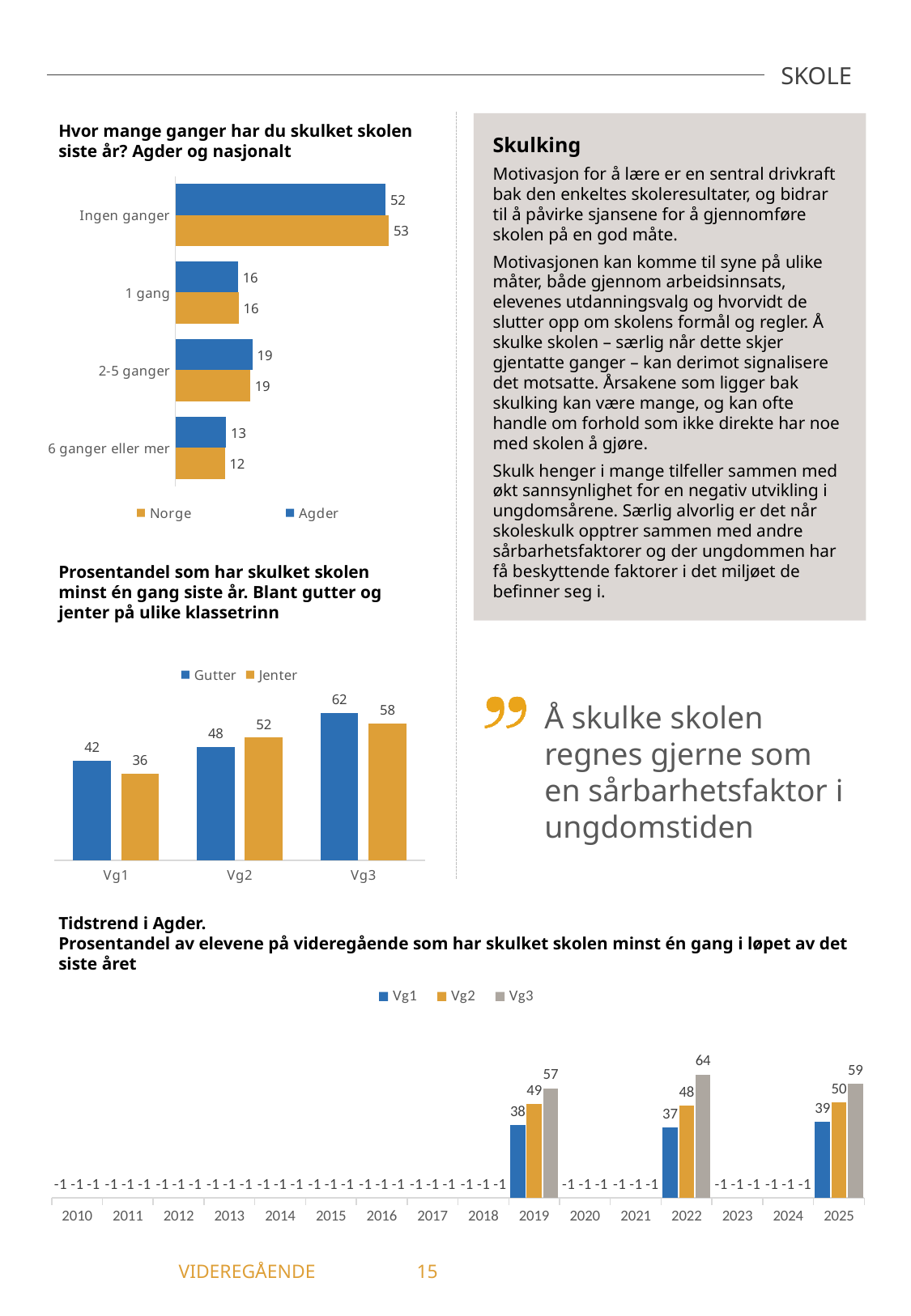
In the chart 'Prosentandel som har skulket skolen minst én gang siste år', what is the difference between Gutter and Jenter at Vg3? 4 In the chart 'Hvor mange ganger har du skulket skolen siste år? Agder og nasjonalt', how many categories are shown? 4 In the chart 'Tidstrend i Agder', what is the value for Vg1 in 2025? 39 In the chart 'Hvor mange ganger har du skulket skolen siste år? Agder og nasjonalt', what is the value for Agder in the category 'Ingen ganger'? 52 What kind of chart is 'Tidstrend i Agder'? bar chart In the chart 'Hvor mange ganger har du skulket skolen siste år? Agder og nasjonalt', which category has the highest value for Agder? Ingen ganger In the chart 'Hvor mange ganger har du skulket skolen siste år? Agder og nasjonalt', what is the value for Norge in the category '6 ganger eller mer'? 12 In the chart 'Tidstrend i Agder', what is the value for Vg3 in 2022? 64 In the chart 'Prosentandel som har skulket skolen minst én gang siste år', do the values for Gutter rise or fall from Vg1 to Vg3? rise In the chart 'Tidstrend i Agder', how many series does the legend list? 3 In the chart 'Prosentandel som har skulket skolen minst én gang siste år', which is larger at Vg1, Gutter or Jenter? Gutter In the chart 'Prosentandel som har skulket skolen minst én gang siste år', what is the value for Jenter at Vg2? 52